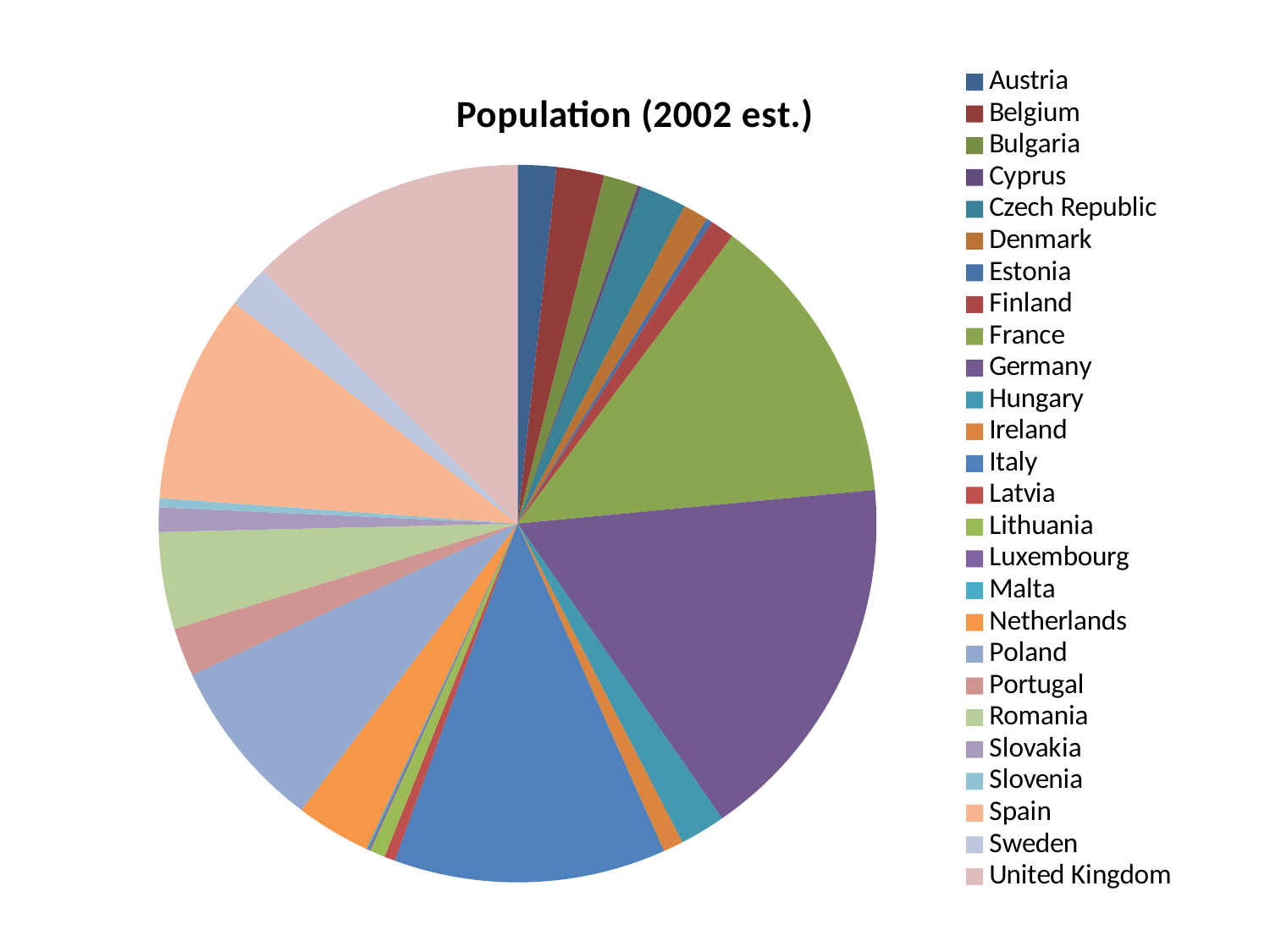
Which slice is larger, Italy or Hungary? Italy How many countries are listed in the chart's legend? 26 Which slice is larger, Germany or Poland? Germany Which country is listed last in the legend? United Kingdom What is the title of the chart? Population (2002 est.) What kind of chart is shown on the slide? pie chart Which slice is larger, United Kingdom or Austria? United Kingdom Which country has the largest slice of the pie? Germany